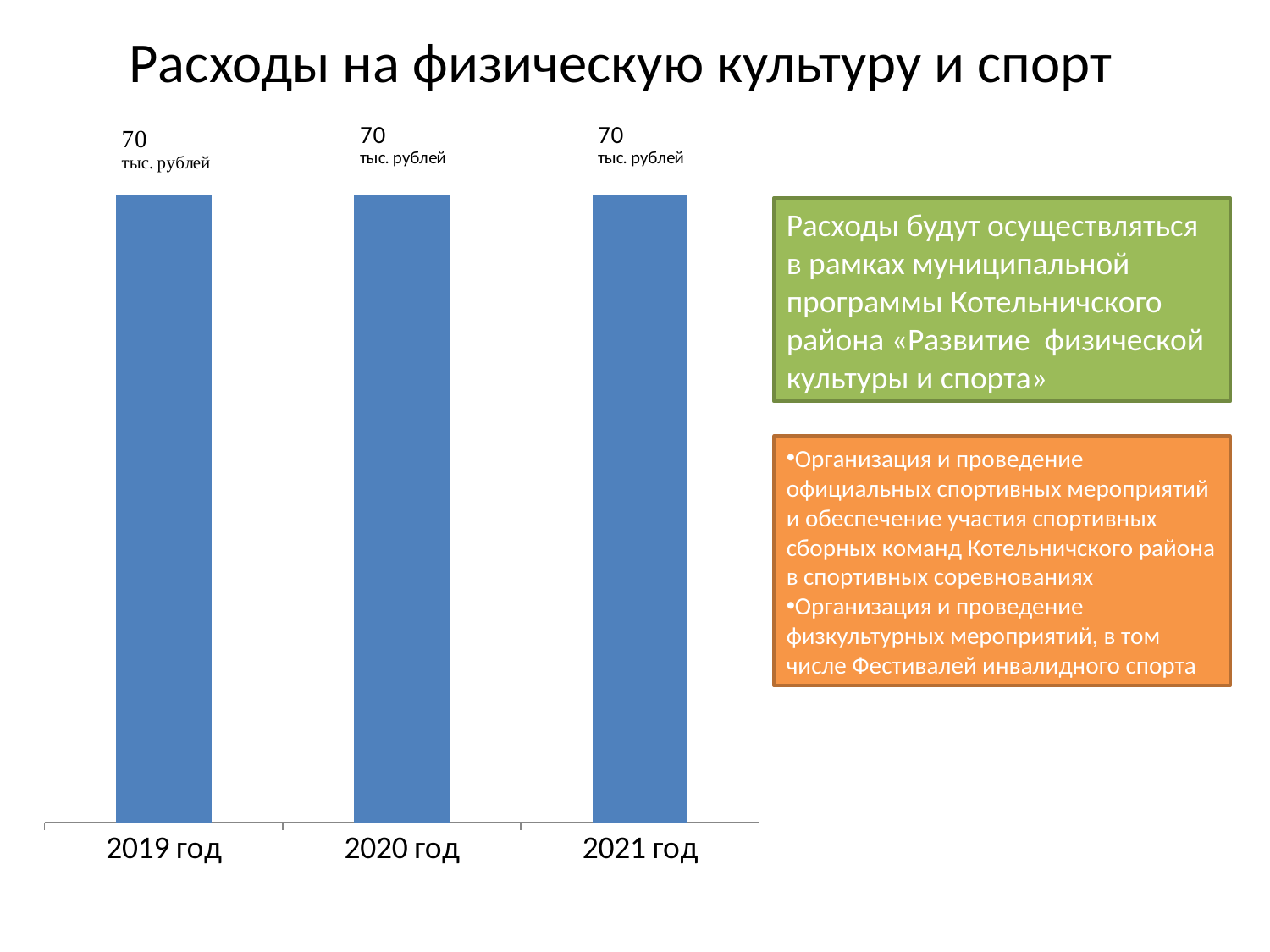
What colour are the bars in the chart? blue How many categories are shown on the x axis? 3 What is the value for 2019 год? 70 тыс. рублей What is the value for 2021 год? 70 тыс. рублей Do the values rise, fall or stay the same from 2019 год to 2021 год? stay the same In what unit are the values on the chart given? тыс. рублей What is the total of the values for 2019 год, 2020 год and 2021 год? 210 тыс. рублей What is the title of the slide containing the chart? Расходы на физическую культуру и спорт What is the difference between the values for 2019 год and 2021 год? 0 What kind of chart is shown on the slide? bar chart What is the value for 2020 год? 70 тыс. рублей